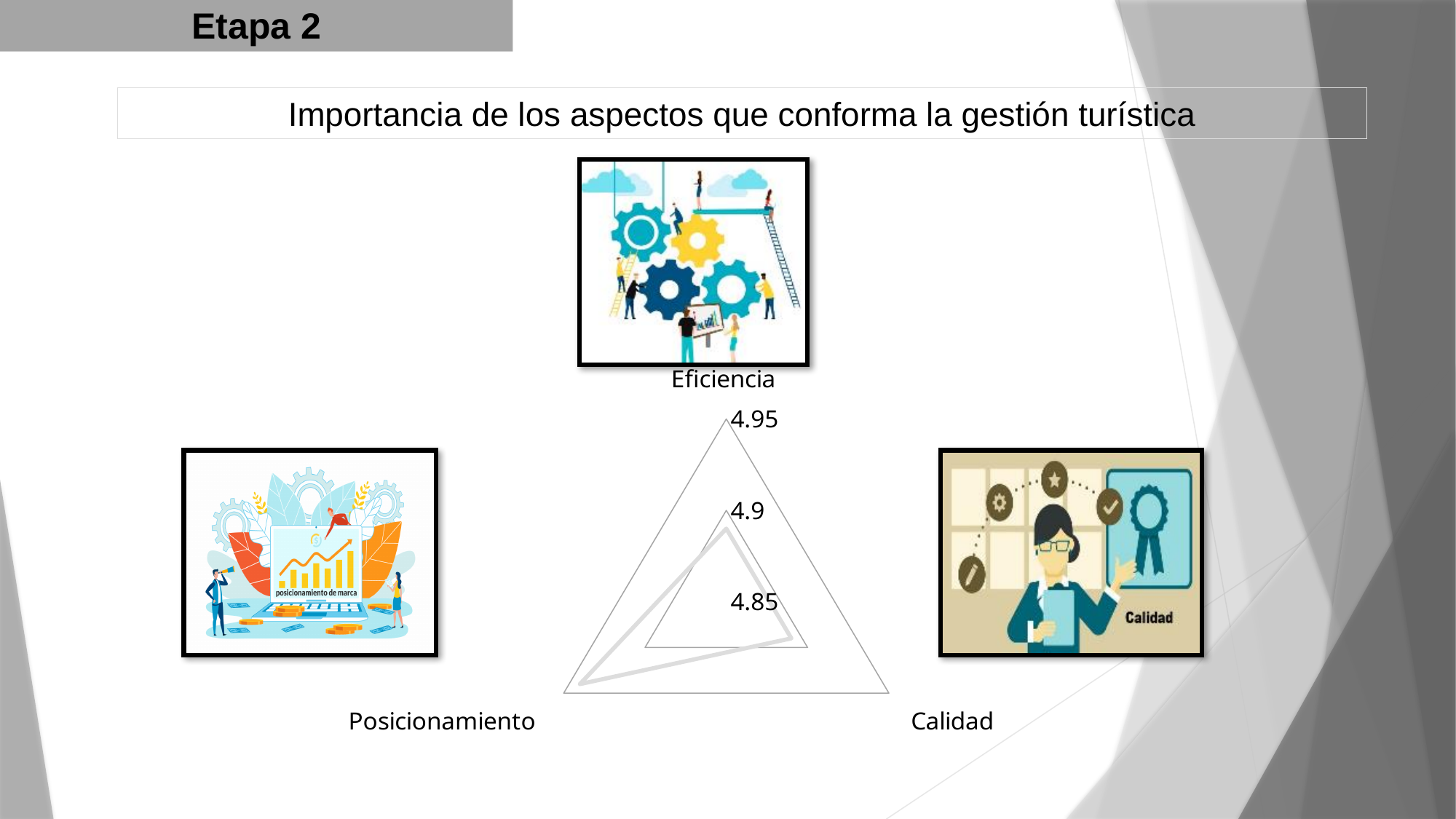
What kind of chart is shown on the slide? radar chart Is the value for Eficiencia greater or less than 4.95? less Which is larger, the value for Posicionamiento or the value for Calidad? Posicionamiento Which category has the highest value in the radar chart? Posicionamiento What is the title shown above the radar chart? Importancia de los aspectos que conforma la gestión turística Is the value for Eficiencia greater or less than 4.9? less What is the highest axis tick value shown on the radar chart? 4.95 Which is larger, the value for Posicionamiento or the value for Eficiencia? Posicionamiento How many categories (axes) does the radar chart have? 3 Is the value for Posicionamiento greater or less than 4.9? greater